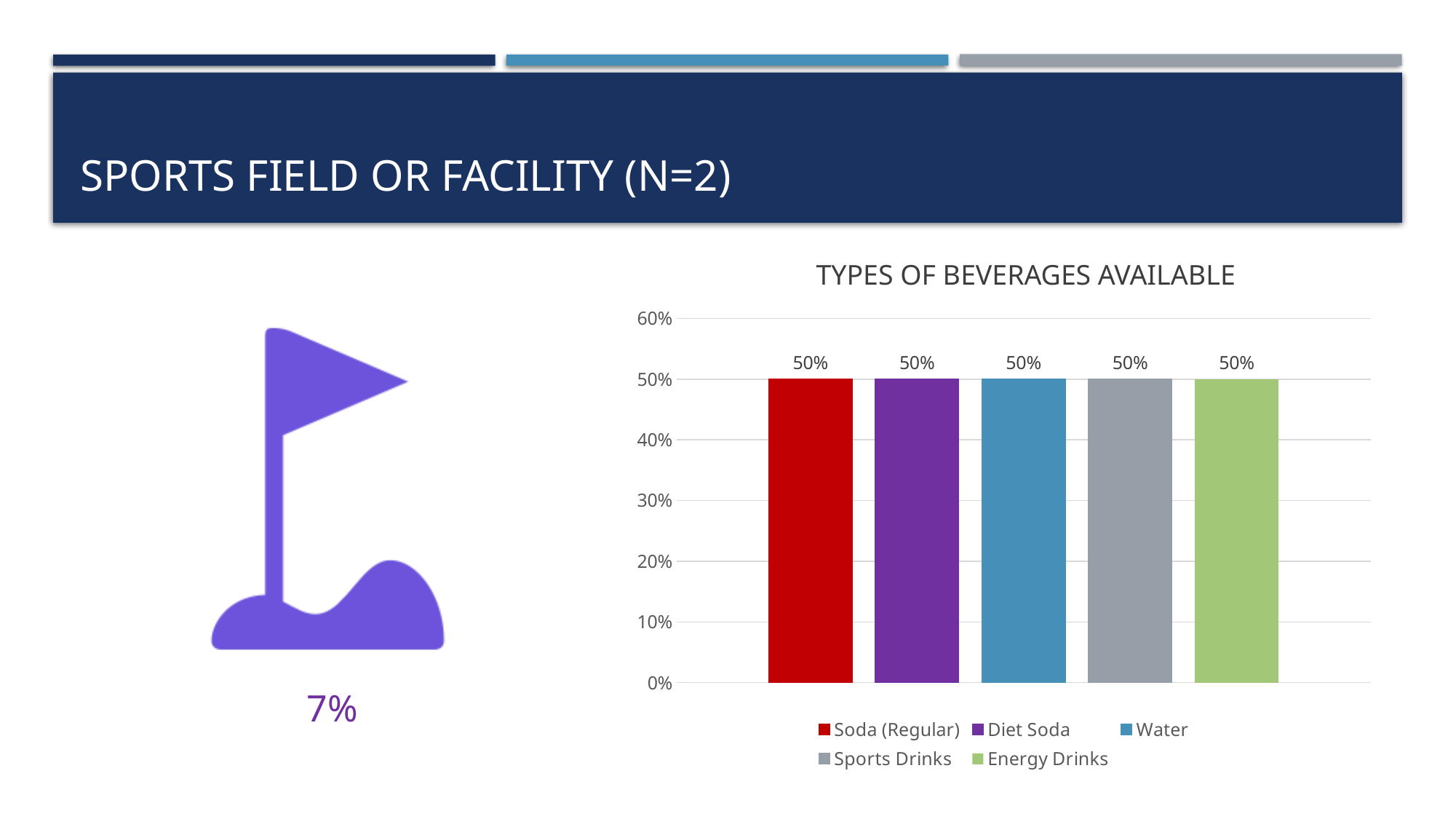
What colour is the Soda (Regular) bar in the Types of Beverages Available chart? Red What is the value for Energy Drinks in the Types of Beverages Available chart? 50% What is the title of the chart on the slide? Types of Beverages Available Is the value for Sports Drinks in the Types of Beverages Available chart greater or less than 40%? greater What is the difference between the values for Diet Soda and Sports Drinks in the Types of Beverages Available chart? 0% Is the value for Diet Soda in the Types of Beverages Available chart greater or less than 60%? less Do the values in the Types of Beverages Available chart rise, fall, or stay the same from left to right? Stay the same How many entries does the legend of the Types of Beverages Available chart list? 5 What kind of chart is the Types of Beverages Available chart? Bar chart What is the value for Water in the Types of Beverages Available chart? 50% How many bars are shown in the Types of Beverages Available chart? 5 What is the value for Soda (Regular) in the Types of Beverages Available chart? 50%